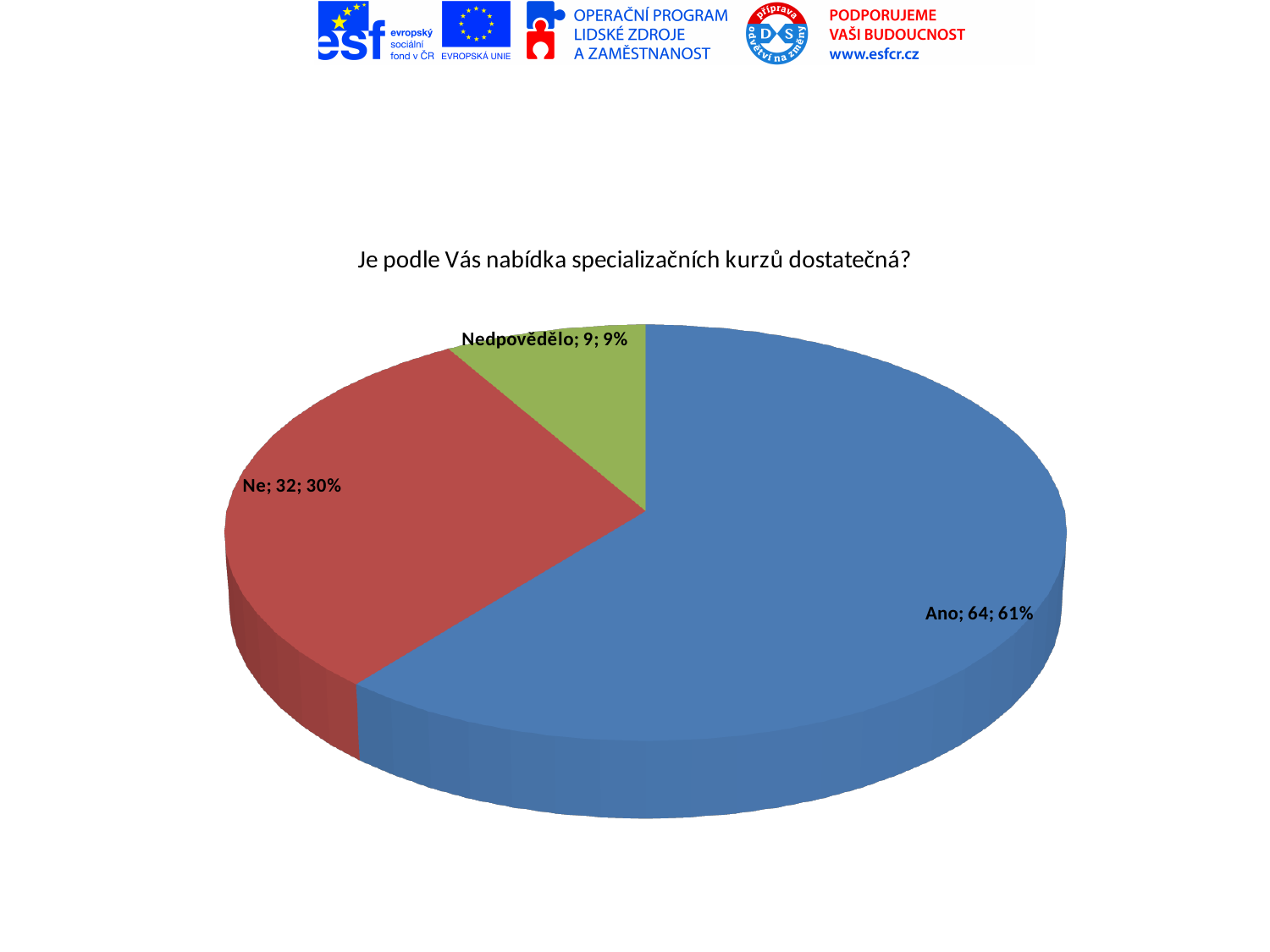
What share of the pie does the "Nedpovědělo" slice represent? 9% How many slices does the pie chart have? 3 Which category has the smallest slice? Nedpovědělo What share of the pie does the "Ano" slice represent? 61% How many respondents answered "Ne"? 32 How many respondents answered "Ano"? 64 Which category has the largest slice? Ano What kind of chart is shown on the slide? pie chart What is the difference between the number of "Ano" and "Ne" responses? 32 What is the title of the chart? Je podle Vás nabídka specializačních kurzů dostatečná? How many respondents are in the "Nedpovědělo" category? 9 What share of the pie does the "Ne" slice represent? 30%